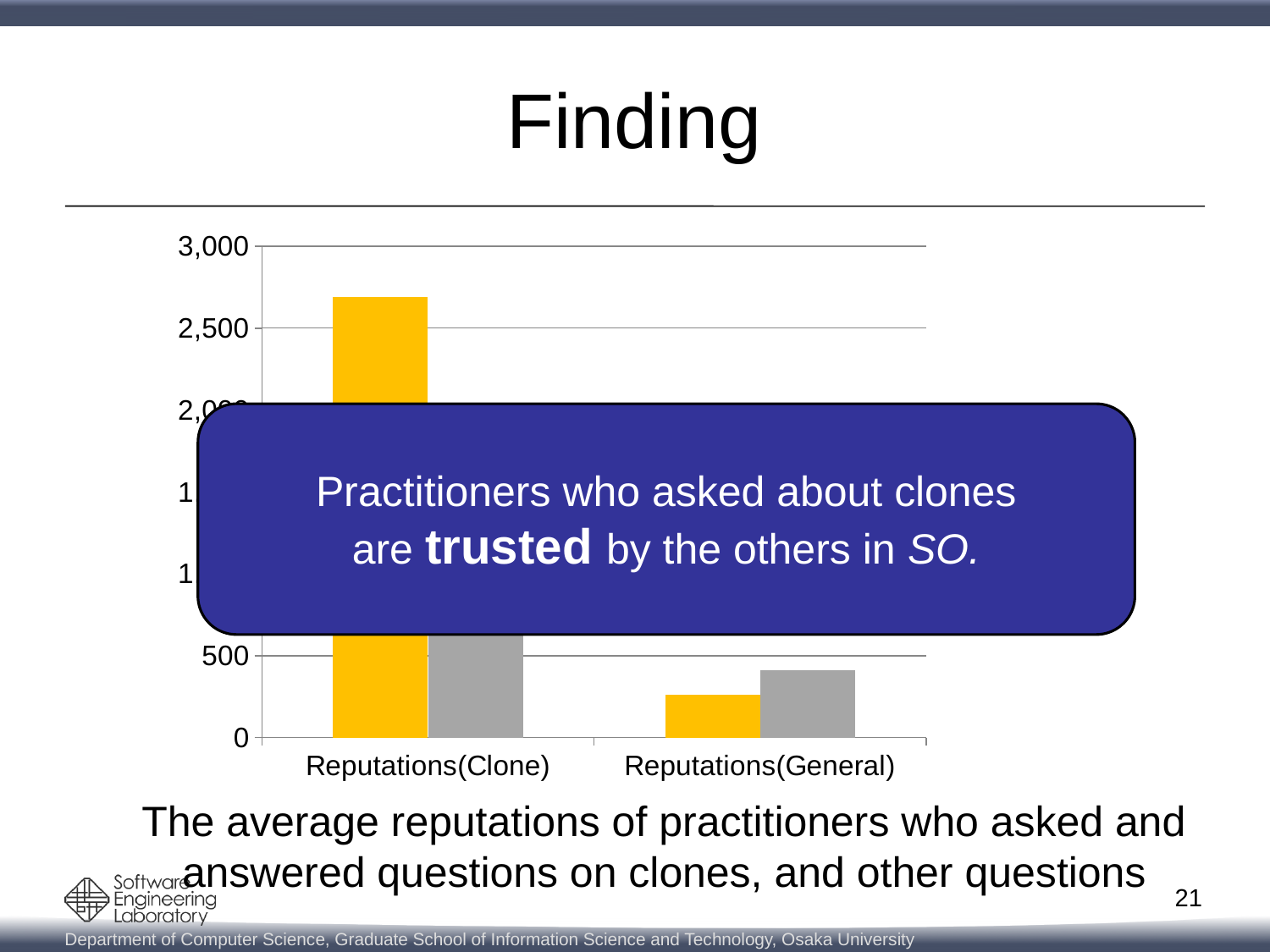
How many categories are shown on the x axis of the chart? 2 Within the Reputations(General) category, which bar is taller, the yellow one or the gray one? the gray one Is the value of the yellow bar for Reputations(General) greater or less than 500? less Do the bar values rise or fall going from Reputations(Clone) to Reputations(General)? fall Is the value of the gray bar for Reputations(General) greater or less than 500? less Is the value of the yellow bar for Reputations(Clone) greater or less than 2,500? greater What is the highest value labelled on the vertical axis of the chart? 3,000 What kind of chart is shown on the slide? bar chart How many bars are plotted for the Reputations(General) category? 2 Which category has the tallest bar in the chart? Reputations(Clone) What two colours are used for the bars in the chart? yellow and gray Which is larger: the yellow bar for Reputations(Clone) or the yellow bar for Reputations(General)? Reputations(Clone)